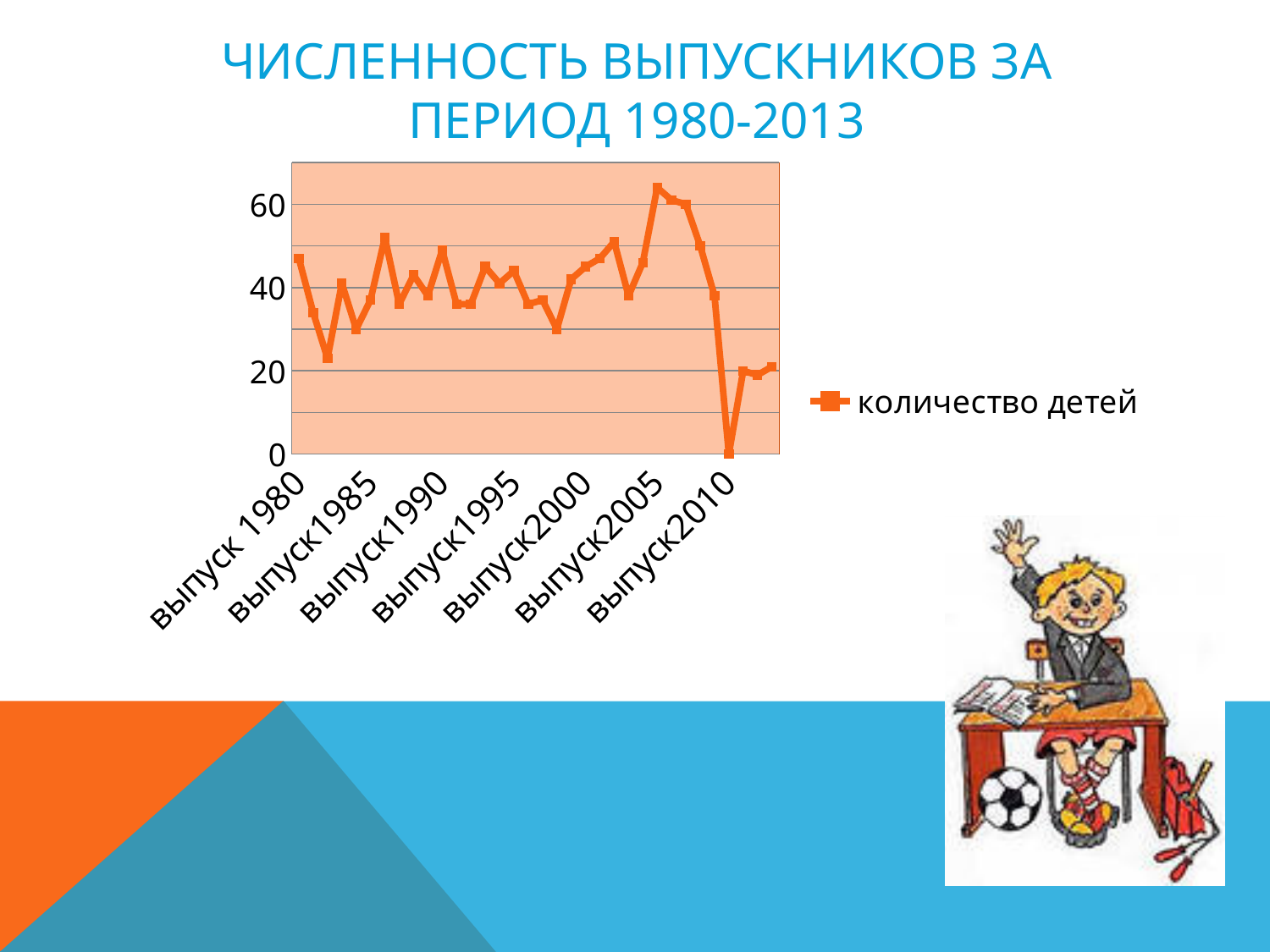
What kind of chart is shown on the slide? line chart Which is larger, the value for выпуск 1980 or the value for выпуск2010? выпуск 1980 How many series does the legend list? 1 What is the name of the series shown in the legend? количество детей How many category labels are shown on the x axis? 7 Does the value rise or fall between выпуск2005 and выпуск2010? fall Is the value for выпуск2010 greater or less than 20? less Is the value for выпуск1990 greater or less than 40? greater What is the title of the chart on the slide? ЧИСЛЕННОСТЬ ВЫПУСКНИКОВ ЗА ПЕРИОД 1980-2013 Is the highest value on the chart greater or less than 60? greater